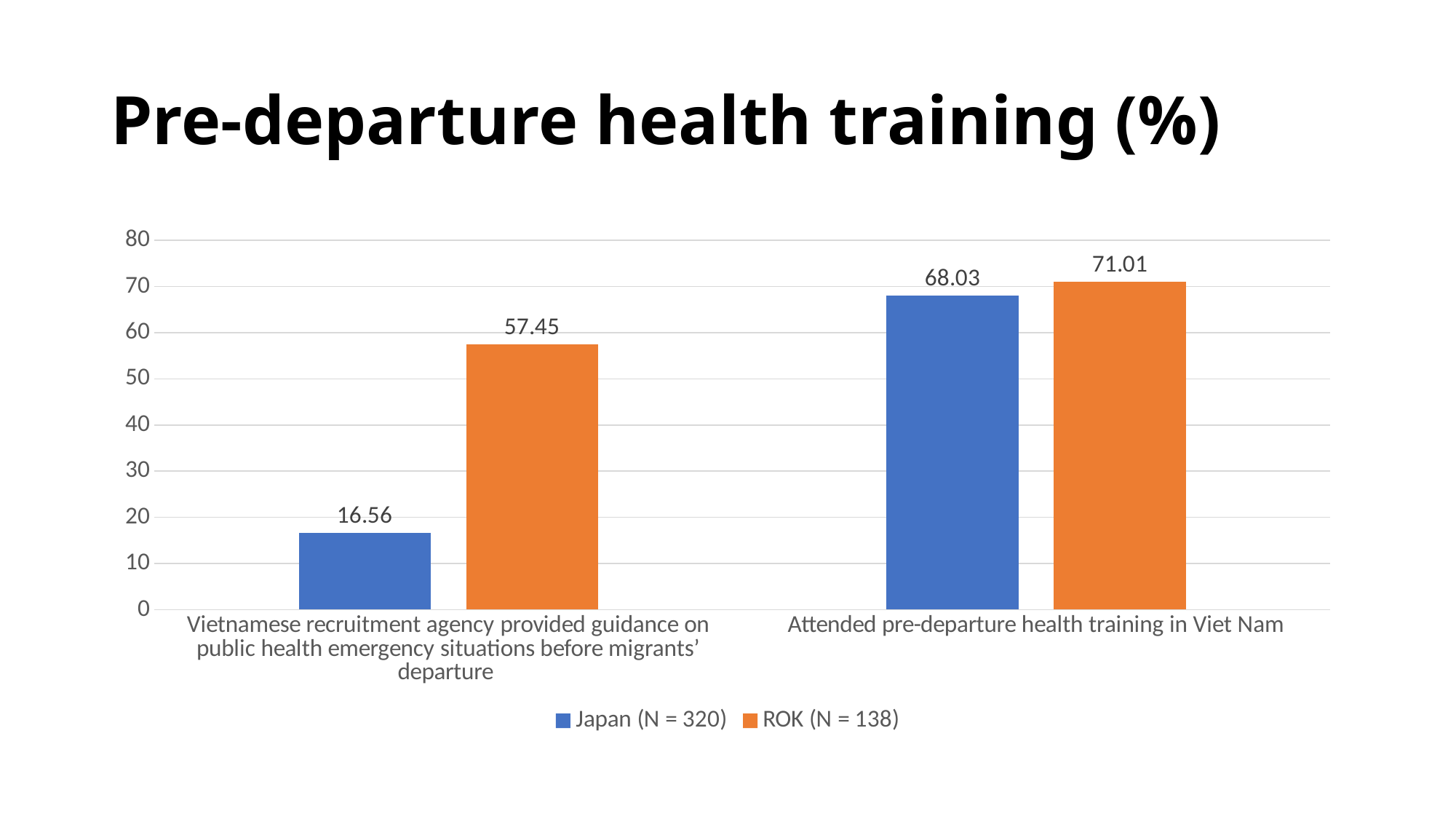
Which bar has the lowest value on the chart? Japan (N = 320), Vietnamese recruitment agency provided guidance on public health emergency situations before migrants' departure What is the value for ROK (N = 138) for 'Attended pre-departure health training in Viet Nam'? 71.01 What is the difference between the ROK (N = 138) and Japan (N = 320) values for 'Vietnamese recruitment agency provided guidance on public health emergency situations before migrants' departure'? 40.89 What is the value for Japan (N = 320) for 'Attended pre-departure health training in Viet Nam'? 68.03 What is the value for Japan (N = 320) for 'Vietnamese recruitment agency provided guidance on public health emergency situations before migrants' departure'? 16.56 How many series does the legend list? 2 Which bar has the highest value on the chart? ROK (N = 138), Attended pre-departure health training in Viet Nam What is the value for ROK (N = 138) for 'Vietnamese recruitment agency provided guidance on public health emergency situations before migrants' departure'? 57.45 For 'Attended pre-departure health training in Viet Nam', which series has the larger value, Japan (N = 320) or ROK (N = 138)? ROK (N = 138) How many categories are shown on the x axis? 2 What is the difference between the ROK (N = 138) and Japan (N = 320) values for 'Attended pre-departure health training in Viet Nam'? 2.98 What kind of chart is shown on the slide? Bar chart